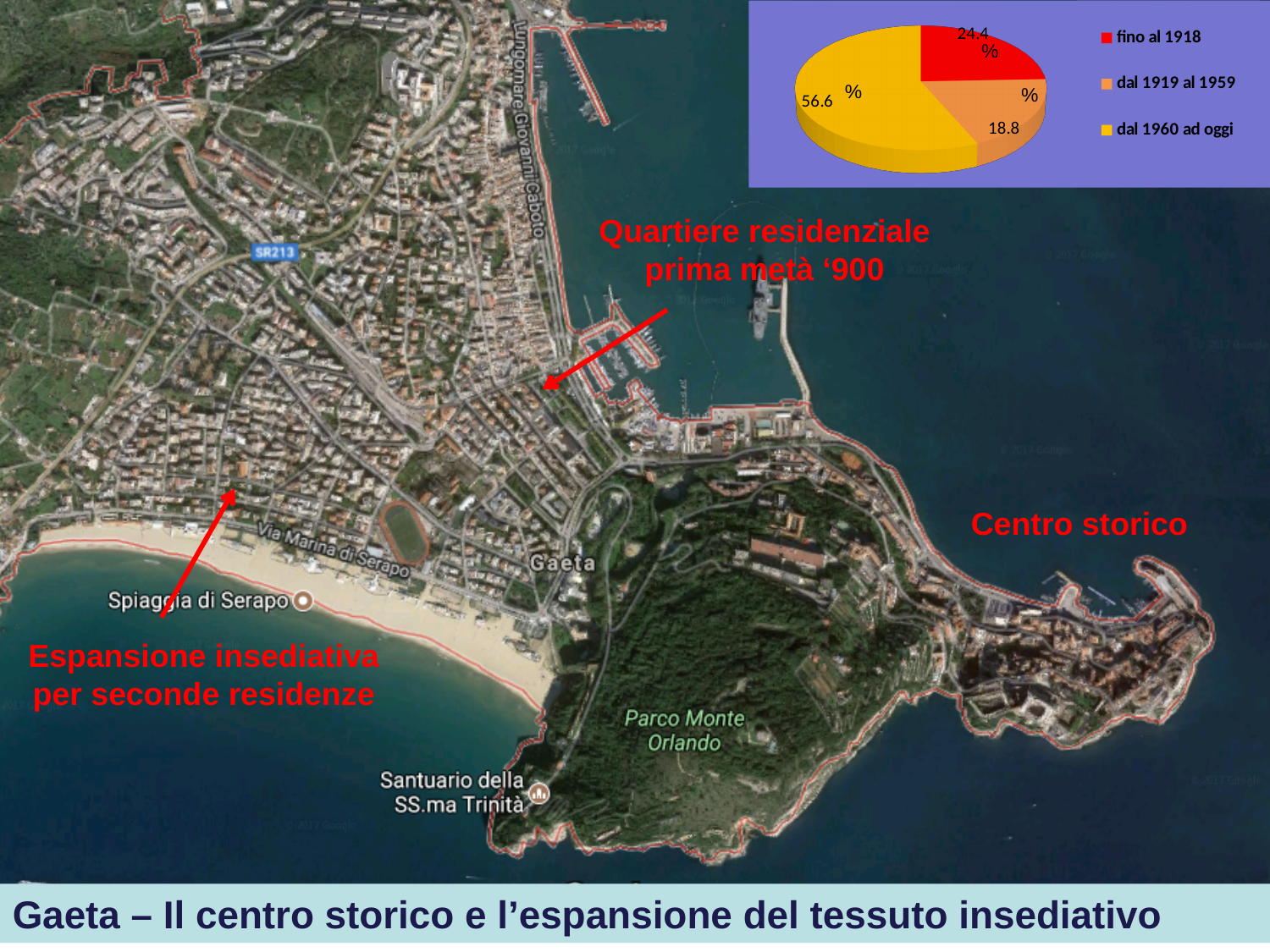
What kind of chart is shown in the top right of the slide? pie chart What colour is the 'fino al 1918' slice in the pie chart? red How many entries does the legend of the pie chart list? 3 What percentage does the pie chart show for 'fino al 1918'? 24.4% What is the difference in percentage points between 'dal 1960 ad oggi' and 'fino al 1918' in the pie chart? 32.2 Which category has the smallest slice in the pie chart? dal 1919 al 1959 Which category has the largest slice in the pie chart? dal 1960 ad oggi In the pie chart, which is larger: 'fino al 1918' or 'dal 1919 al 1959'? fino al 1918 What colour is the 'dal 1960 ad oggi' slice in the pie chart? yellow What percentage does the pie chart show for 'dal 1960 ad oggi'? 56.6% What percentage does the pie chart show for 'dal 1919 al 1959'? 18.8% How many slices does the pie chart have? 3